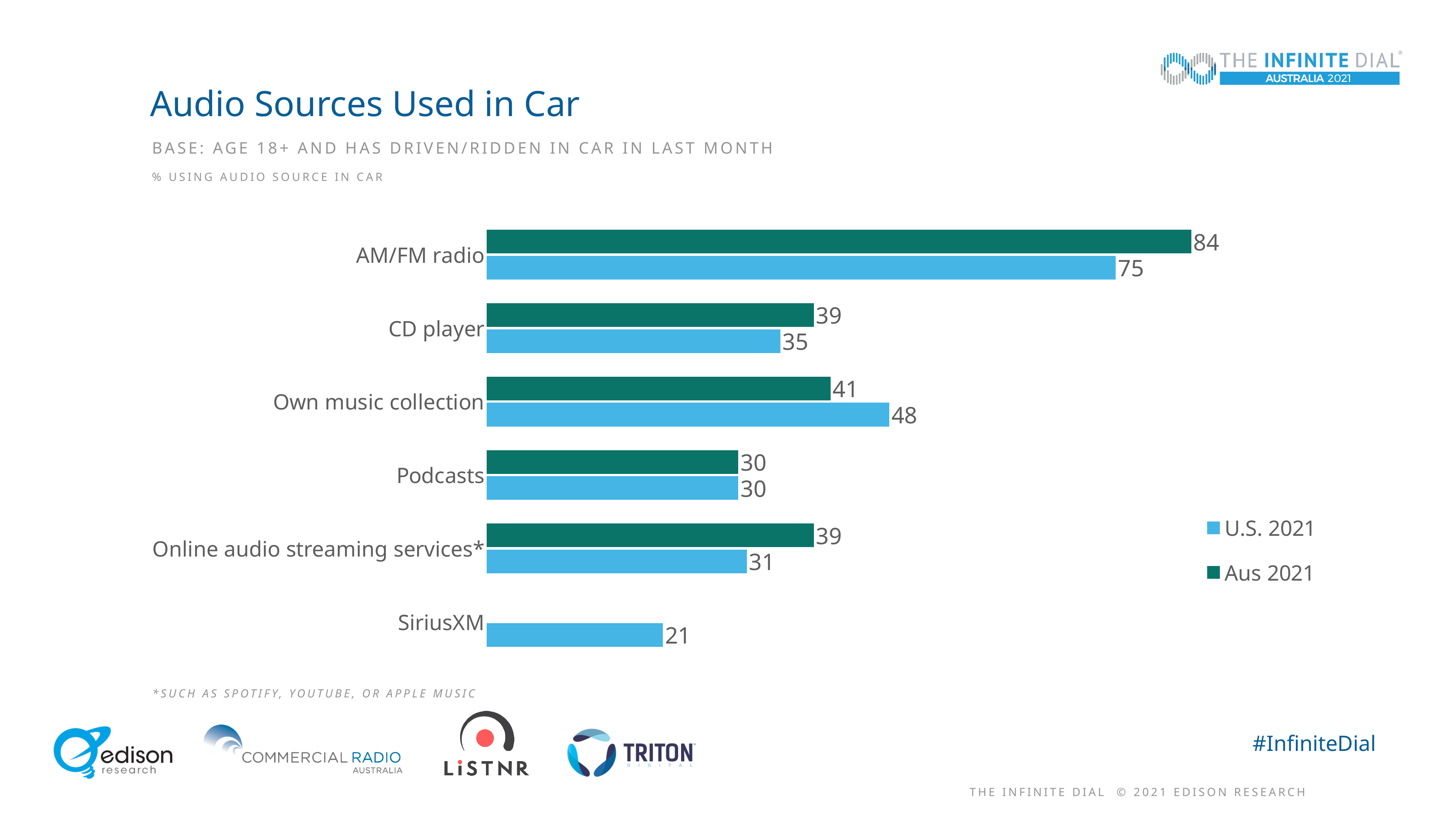
What is the U.S. 2021 value for SiriusXM? 21 Which audio source has the lowest U.S. 2021 value? SiriusXM What is the difference between the U.S. 2021 and Aus 2021 values for Own music collection? 7 Which is larger for Online audio streaming services: the Aus 2021 value or the U.S. 2021 value? Aus 2021 What is the U.S. 2021 value for Own music collection? 48 Which audio source has the highest Aus 2021 value? AM/FM radio How many series does the legend list? 2 What is the Aus 2021 value for AM/FM radio? 84 Which category has no Aus 2021 bar? SiriusXM What kind of chart is shown on the slide? Bar chart What is the difference between the Aus 2021 and U.S. 2021 values for AM/FM radio? 9 How many audio source categories are shown on the chart? 6